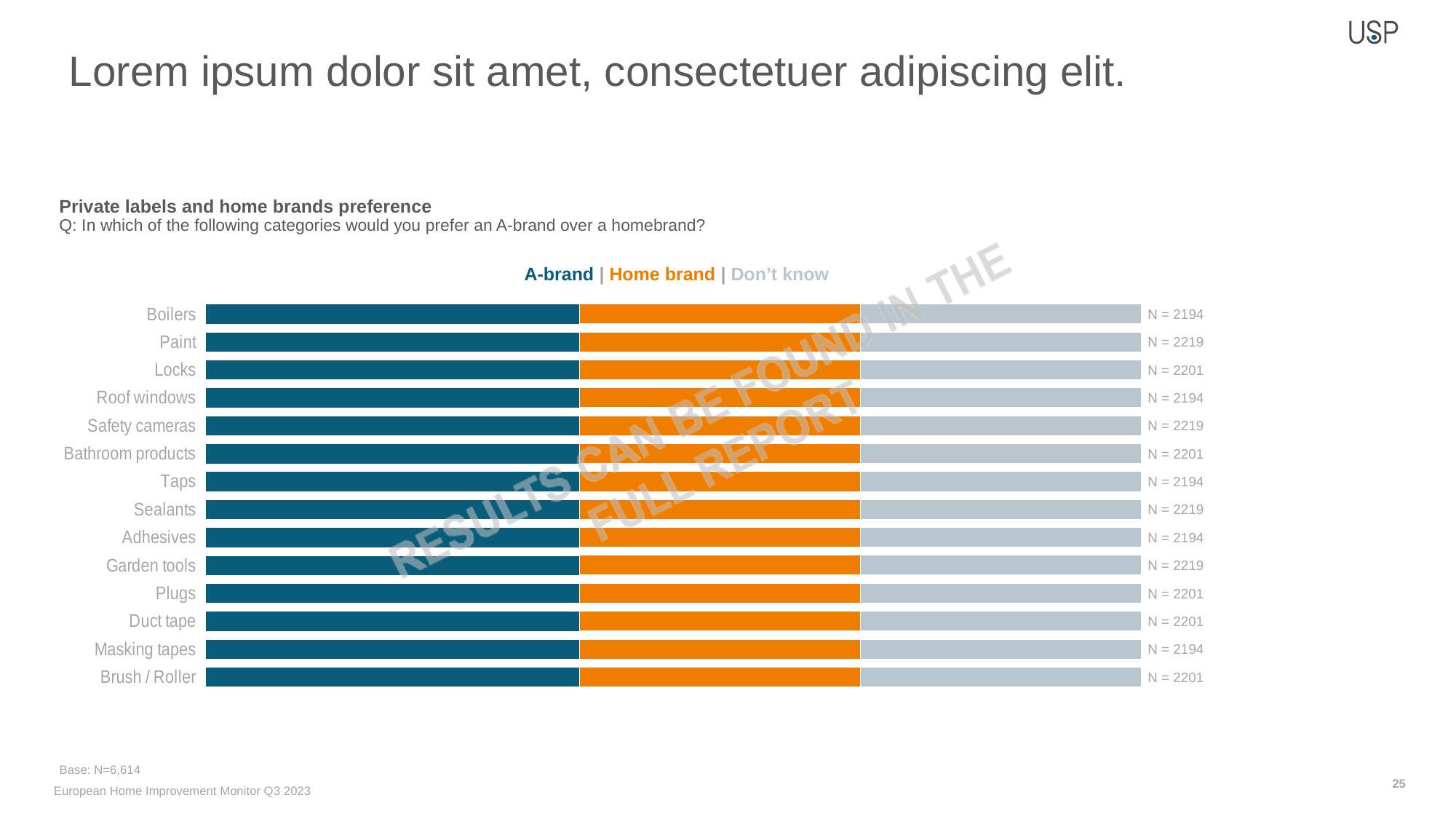
What is the N value shown for Boilers? N = 2194 What is the N value shown for Brush / Roller? N = 2201 How many series does the legend list? 3 What is the base sample size stated below the chart? N=6,614 How many categories are listed on the chart? 14 Which category is listed first (at the top) of the chart? Boilers What is the N value shown for Paint? N = 2219 What kind of chart is shown on the slide? Stacked bar chart Which series is shown in orange in the legend? Home brand What is the N value shown for Garden tools? N = 2219 What is the N value shown for Locks? N = 2201